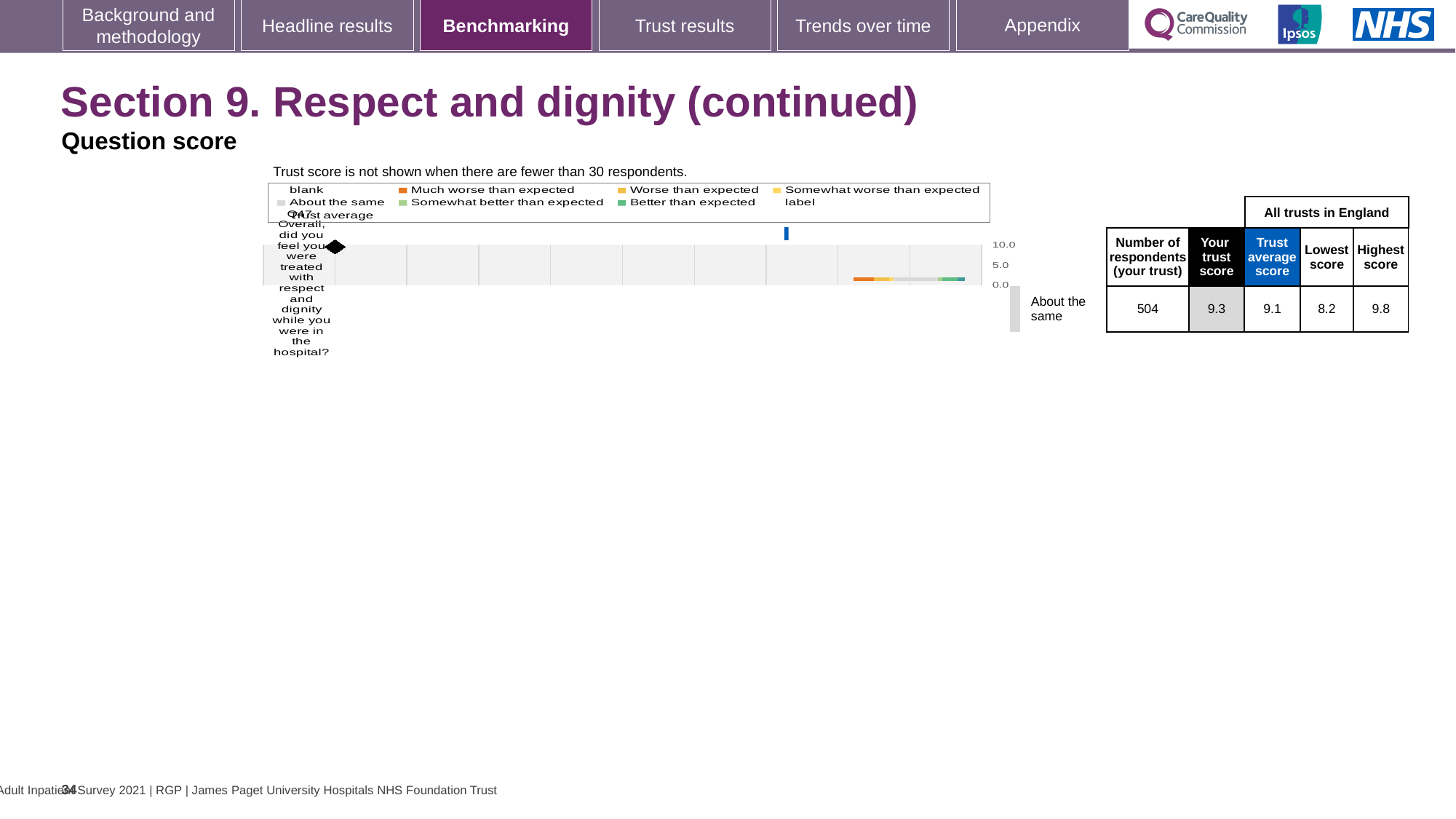
What kind of chart is shown on the slide? bar chart In the table beside the chart, what is the highest score among all trusts in England for Q47? 9.8 In the table beside the chart, what is the trust score for Q47? 9.3 For Q47, what is the difference between the highest score and the lowest score among all trusts in England? 1.6 For Q47, which is larger: the trust's own score or the trust average score for all trusts in England? the trust's own score What benchmark category label is shown next to the chart for Q47? About the same In the table beside the chart, what is the trust average score for all trusts in England for Q47? 9.1 How many survey questions are plotted as categories in the chart? 1 In the table beside the chart, what is the lowest score among all trusts in England for Q47? 8.2 Which legend entry in the chart is shown in orange? Much worse than expected What is the highest tick value shown on the chart's score axis? 10.0 In the table beside the chart, how many respondents from the trust answered Q47? 504